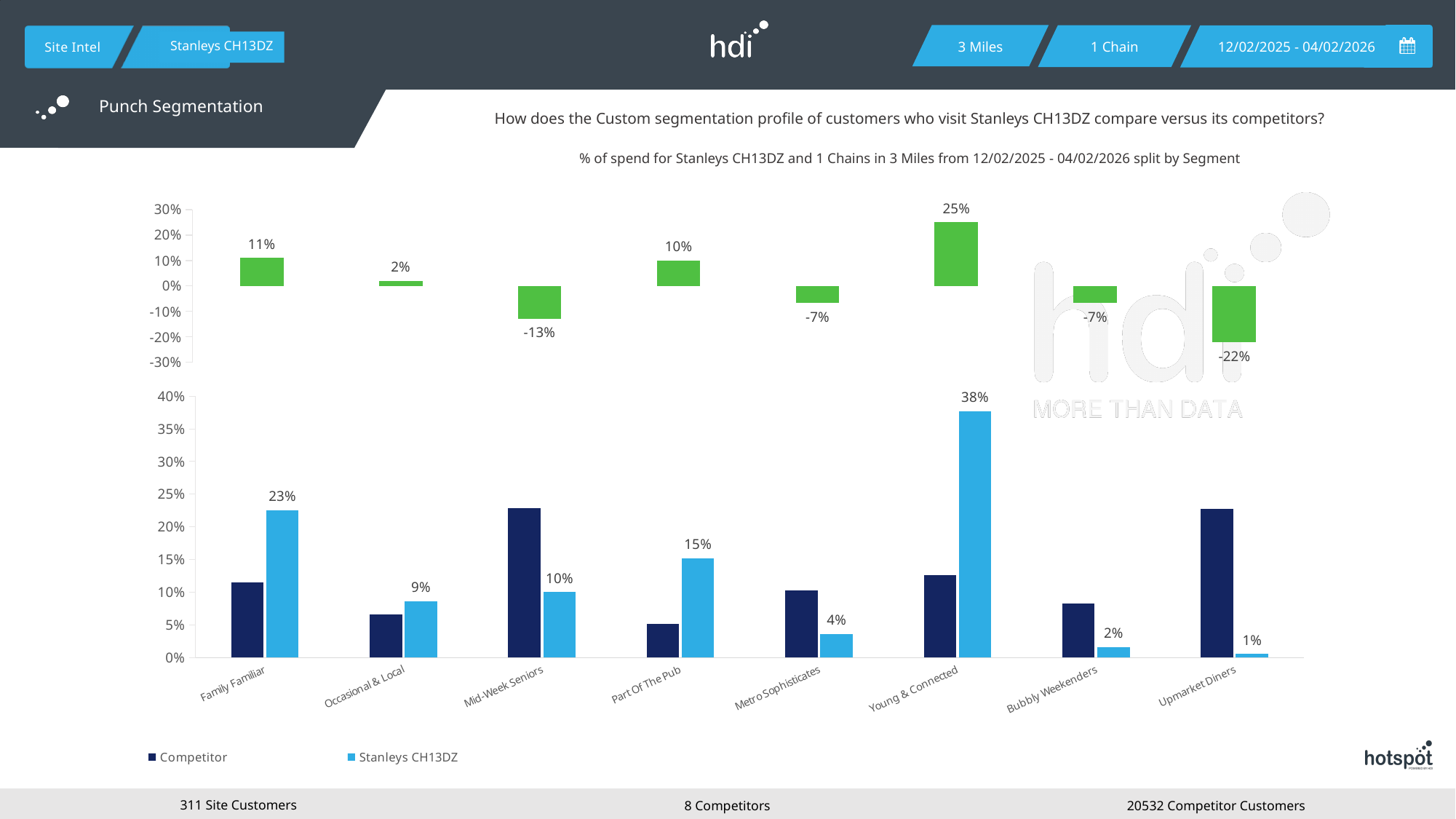
In the bottom chart, what is the value for Stanleys CH13DZ in the Part Of The Pub segment? 15% In the bottom chart, is the Competitor value for Part Of The Pub greater or less than 10%? less In the top chart, which segment has the highest value? Young & Connected In the bottom chart, what is the difference between the Stanleys CH13DZ values for Family Familiar and Occasional & Local? 14% In the bottom chart, which segment has the lowest Stanleys CH13DZ value? Upmarket Diners In the bottom chart, which is larger for Stanleys CH13DZ: Mid-Week Seniors or Metro Sophisticates? Mid-Week Seniors What kind of chart is the bottom chart? Bar chart How many segments are shown on the x axis of the bottom chart? 8 In the bottom chart, what is the value for Stanleys CH13DZ in the Young & Connected segment? 38% How many series does the legend of the bottom chart list? 2 In the top chart, what is the value shown for Upmarket Diners? -22% In the bottom chart, is the Competitor value for Mid-Week Seniors greater or less than 20%? greater